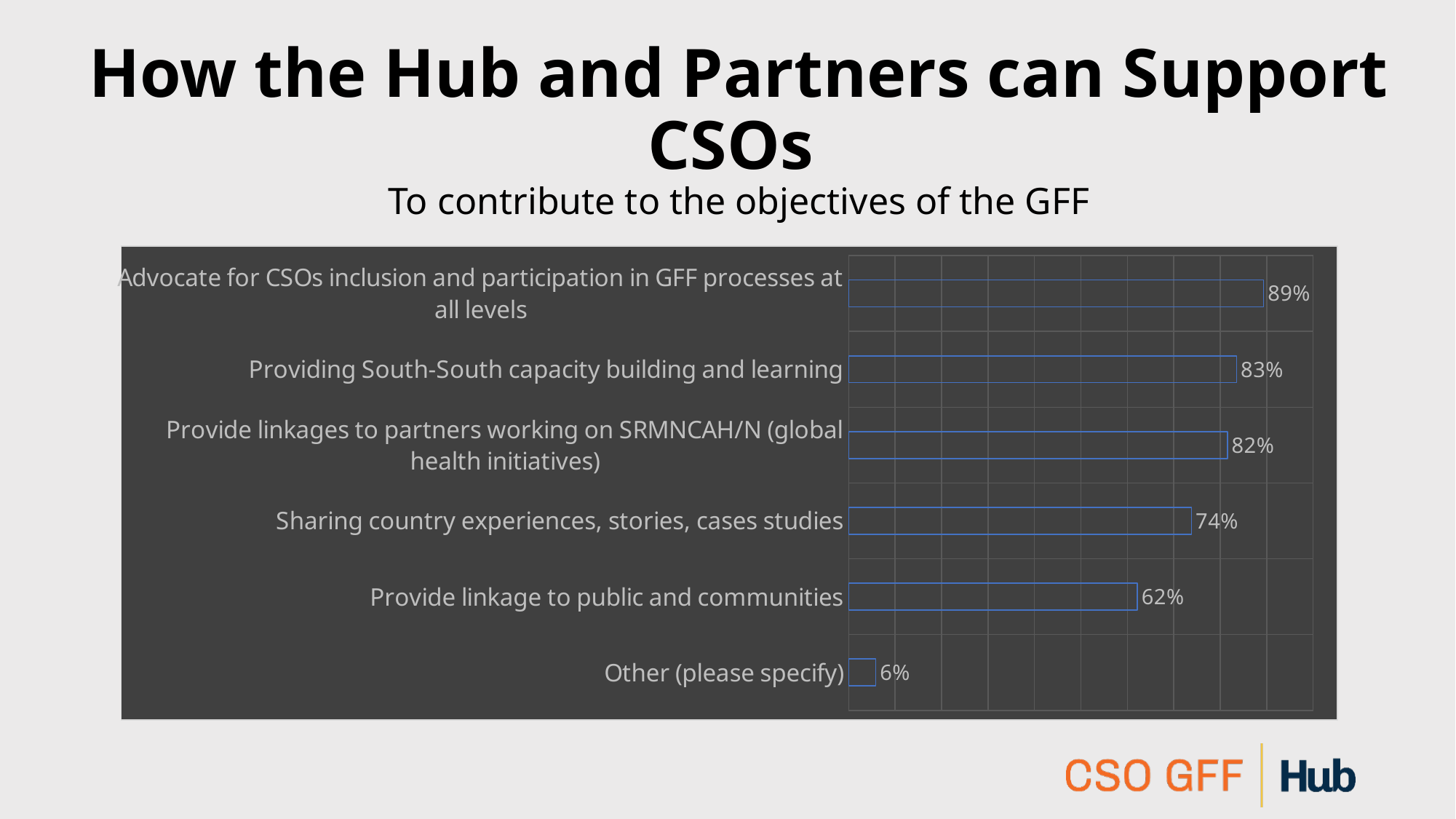
What is the value for 'Other (please specify)'? 6% Which is larger: the value for 'Sharing country experiences, stories, cases studies' or 'Provide linkages to partners working on SRMNCAH/N (global health initiatives)'? Provide linkages to partners working on SRMNCAH/N (global health initiatives) What is the value for 'Providing South-South capacity building and learning'? 83% Which category has the lowest value? Other (please specify) What kind of chart is shown on the slide? Bar chart Which category has the highest value? Advocate for CSOs inclusion and participation in GFF processes at all levels What is the value for 'Sharing country experiences, stories, cases studies'? 74% What percentage is shown for 'Advocate for CSOs inclusion and participation in GFF processes at all levels'? 89% What is the value for 'Provide linkage to public and communities'? 62% How many categories are shown in the chart? 6 What is the difference between the highest and lowest values in the chart? 83% What is the difference between the values for 'Providing South-South capacity building and learning' and 'Provide linkage to public and communities'? 21%